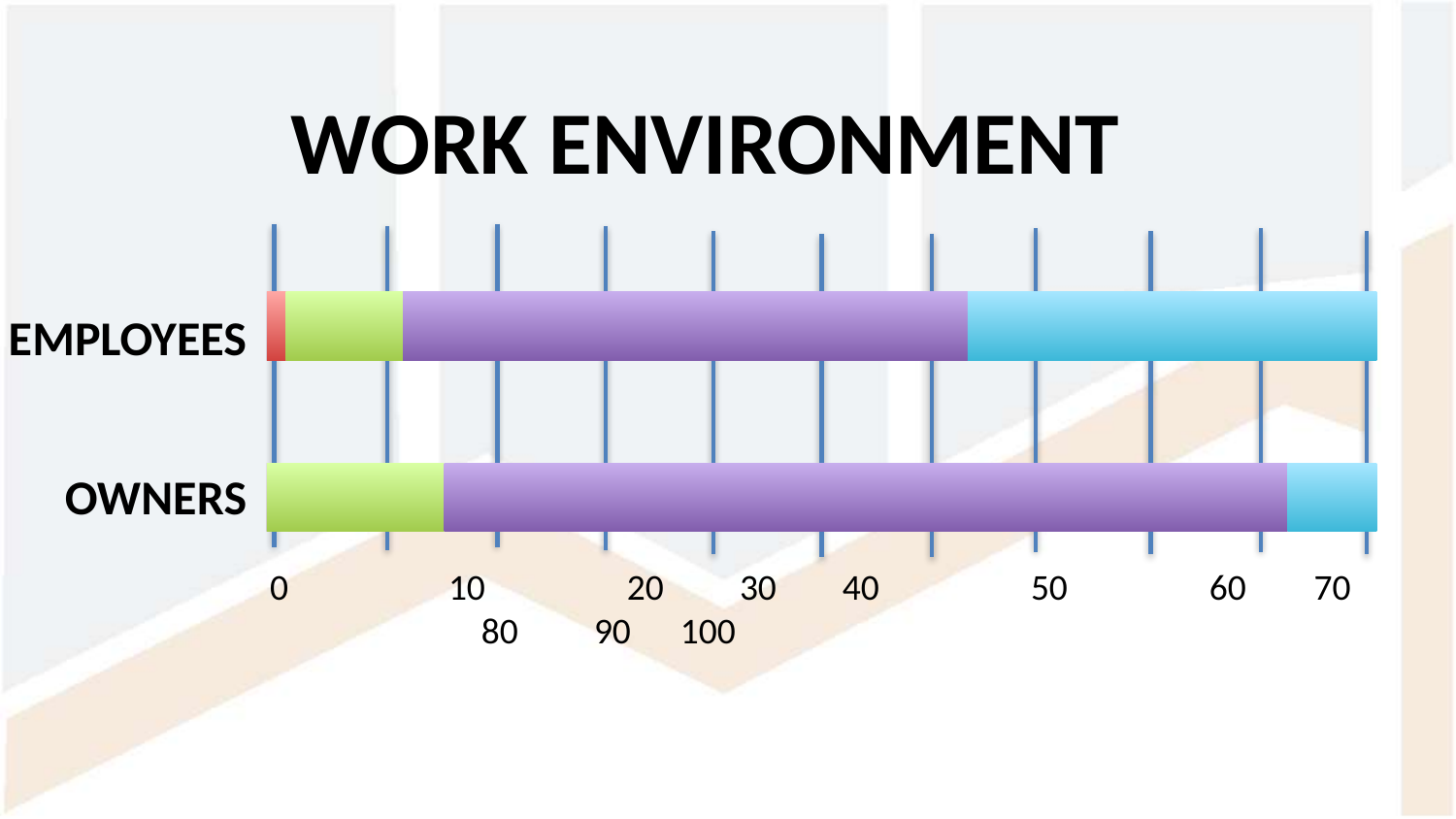
Is the purple segment for OWNERS greater or less than 70? greater Which category has the larger green segment, EMPLOYEES or OWNERS? OWNERS Is the light blue segment for OWNERS greater or less than 10? less Is the light blue segment for EMPLOYEES greater or less than 30? greater What kind of chart is shown on the slide? Stacked horizontal bar chart How many coloured segments make up the EMPLOYEES bar? 4 How many coloured segments make up the OWNERS bar? 3 How many categories are shown on the chart? 2 Which category's bar includes a red segment? EMPLOYEES What is the title of the chart? WORK ENVIRONMENT Which category has the larger purple segment, EMPLOYEES or OWNERS? OWNERS Which category has the larger light blue segment, EMPLOYEES or OWNERS? EMPLOYEES